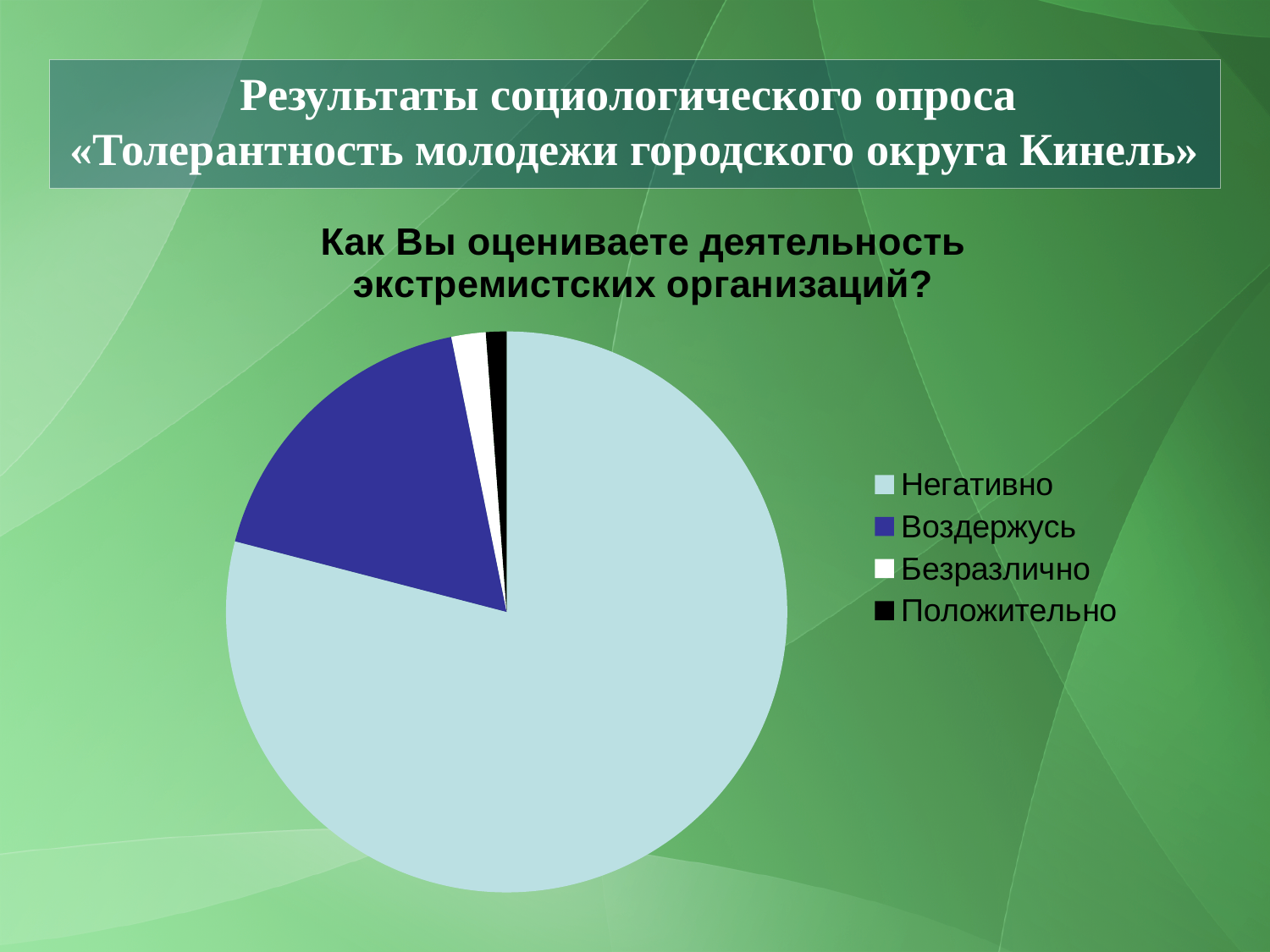
Which category has the largest slice in the pie chart? Негативно What kind of chart is shown on the slide? pie chart What colour is the slice for Положительно in the pie chart? black Which category has the smallest slice in the pie chart? Положительно Which category has the second-largest slice in the pie chart? Воздержусь What question is the pie chart titled with? Как Вы оцениваете деятельность экстремистских организаций? Which slice is larger, Негативно or Воздержусь? Негативно Which slice is larger, Воздержусь or Безразлично? Воздержусь Which slice is larger, Безразлично or Положительно? Безразлично How many slices does the pie chart have? 4 How many entries does the legend of the pie chart list? 4